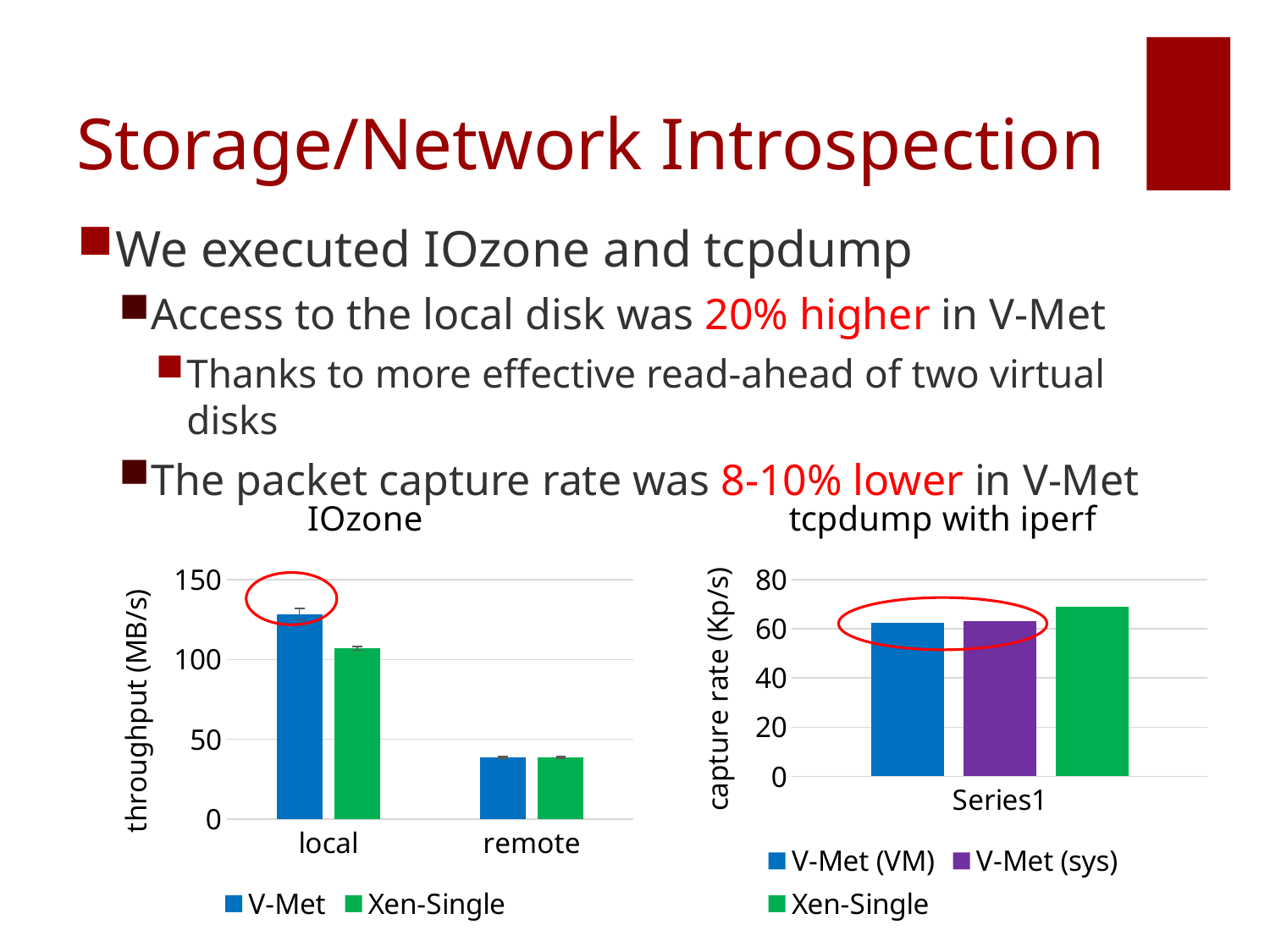
What kind of chart is the IOzone chart? bar chart What is the title of the chart on the right side of the slide? tcpdump with iperf In the tcpdump with iperf chart, is the capture rate for Xen-Single greater or less than 60? greater In the IOzone chart, is the Xen-Single throughput for remote greater or less than 50? less How many series does the legend of the IOzone chart list? 2 In the IOzone chart, which series has the higher throughput for local, V-Met or Xen-Single? V-Met How many series does the legend of the tcpdump with iperf chart list? 3 In the IOzone chart, is the V-Met throughput for local greater or less than 100? greater How many categories are shown on the x axis of the IOzone chart? 2 In the tcpdump with iperf chart, which series has the highest capture rate? Xen-Single What is the y-axis label of the IOzone chart? throughput (MB/s)